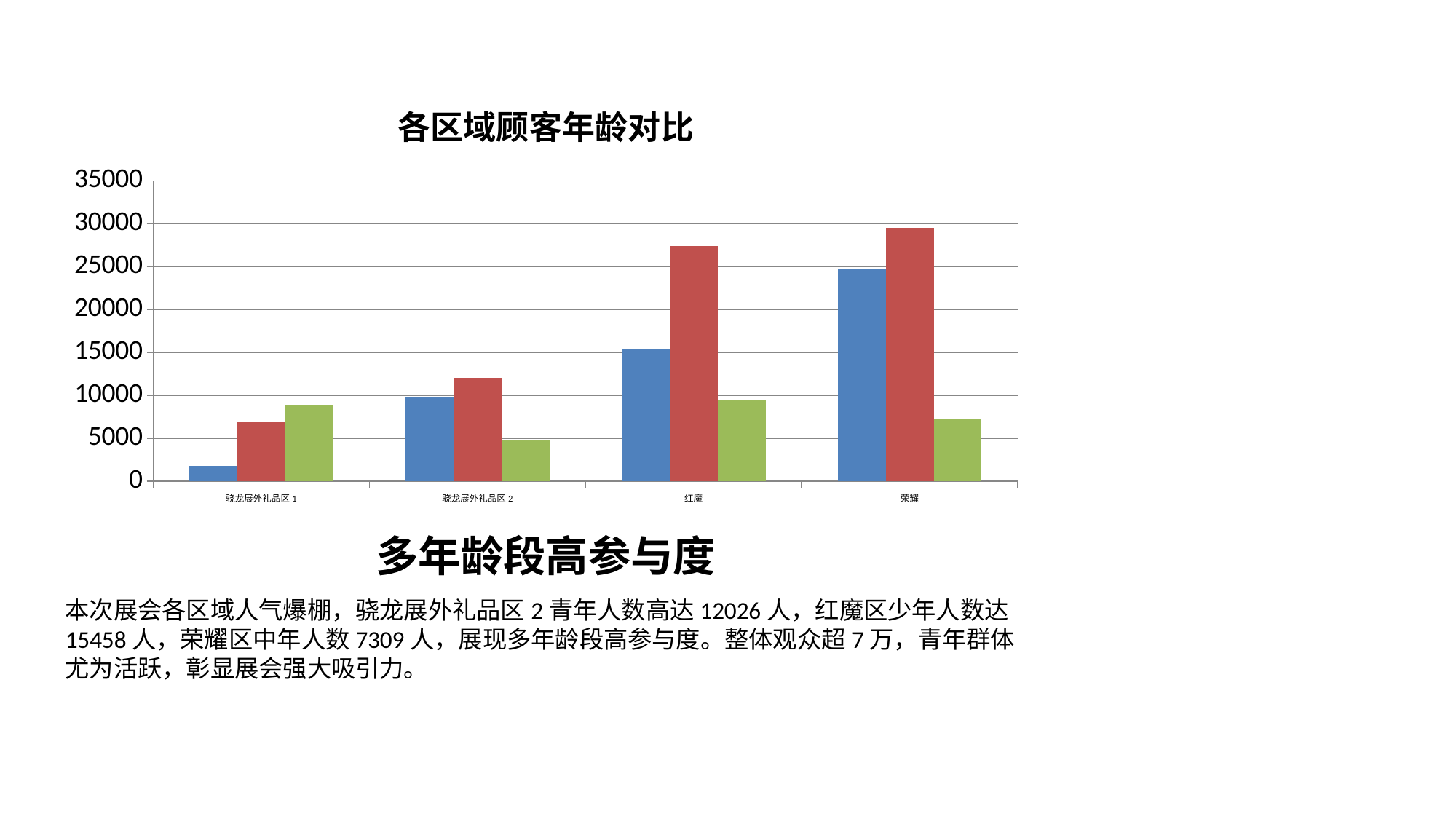
What type of chart is shown on the slide? bar chart Is the red bar for 骁龙展外礼品区 2 greater or less than 10000? greater Is the blue bar for 骁龙展外礼品区 1 greater or less than 5000? less How many bars are plotted for each category in the chart? 3 Do the red bars rise or fall from 骁龙展外礼品区 1 to 荣耀 along the x axis? rise What is the title of the chart? 各区域顾客年龄对比 How many categories are shown on the x axis of the chart? 4 Is the red bar for 红魔 greater or less than 25000? greater Which is larger, the red bar for 红魔 or the red bar for 荣耀? 荣耀 Which category has the tallest bar in the chart? 荣耀 Which category contains the shortest bar in the chart? 骁龙展外礼品区 1